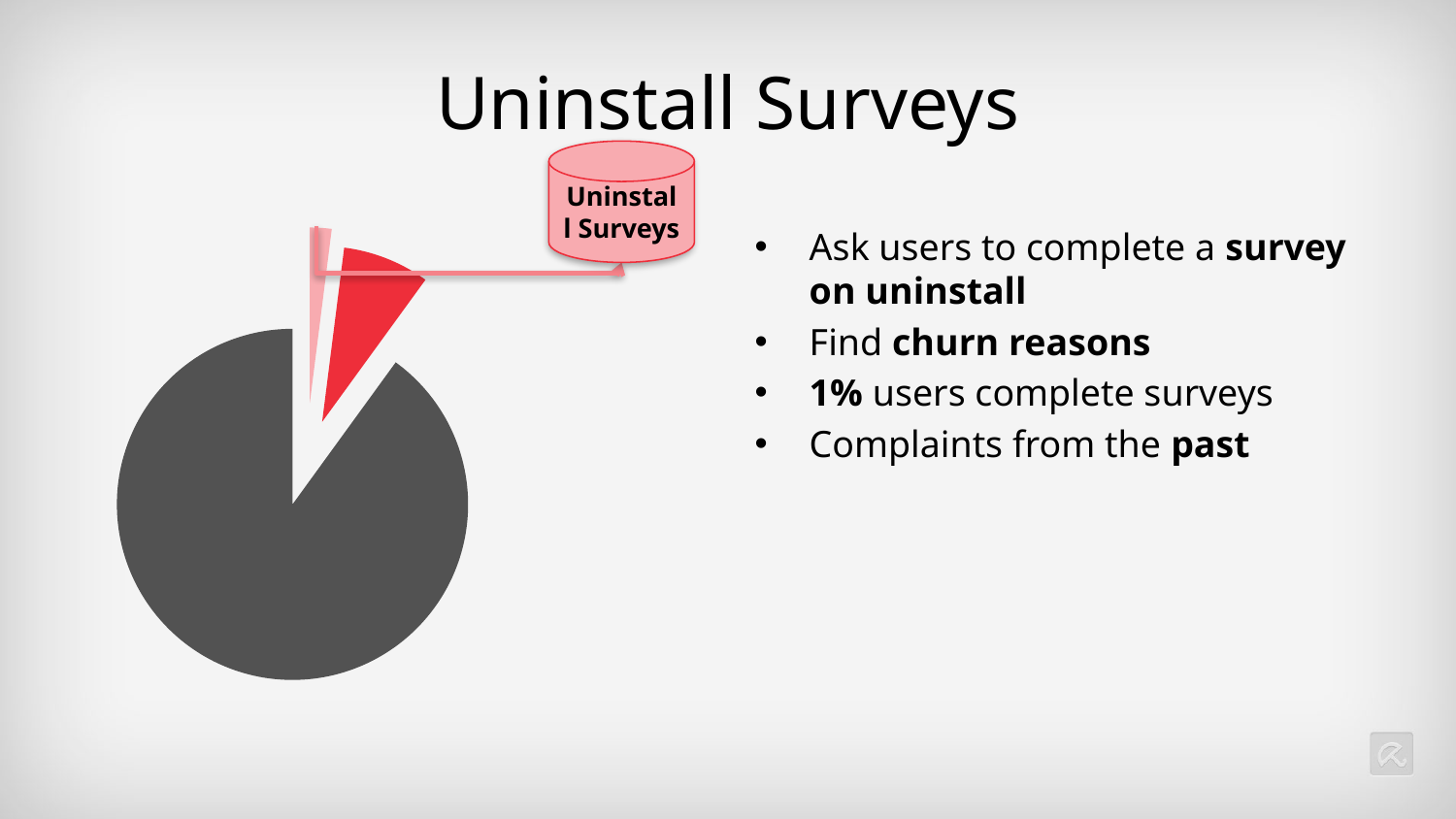
Which slice of the pie chart is the largest? the dark grey slice Which slices of the pie chart are pulled out (exploded) from the rest of the pie? the red and light pink slices What colour is the largest slice of the pie chart? dark grey Which slice of the pie chart is the smallest? the thin light pink slice How many slices does the pie chart have? 3 What kind of chart is shown on the slide? pie chart Which is larger in the pie chart, the dark grey slice or the red slice? the dark grey slice Which is larger in the pie chart, the red slice or the light pink slice? the red slice